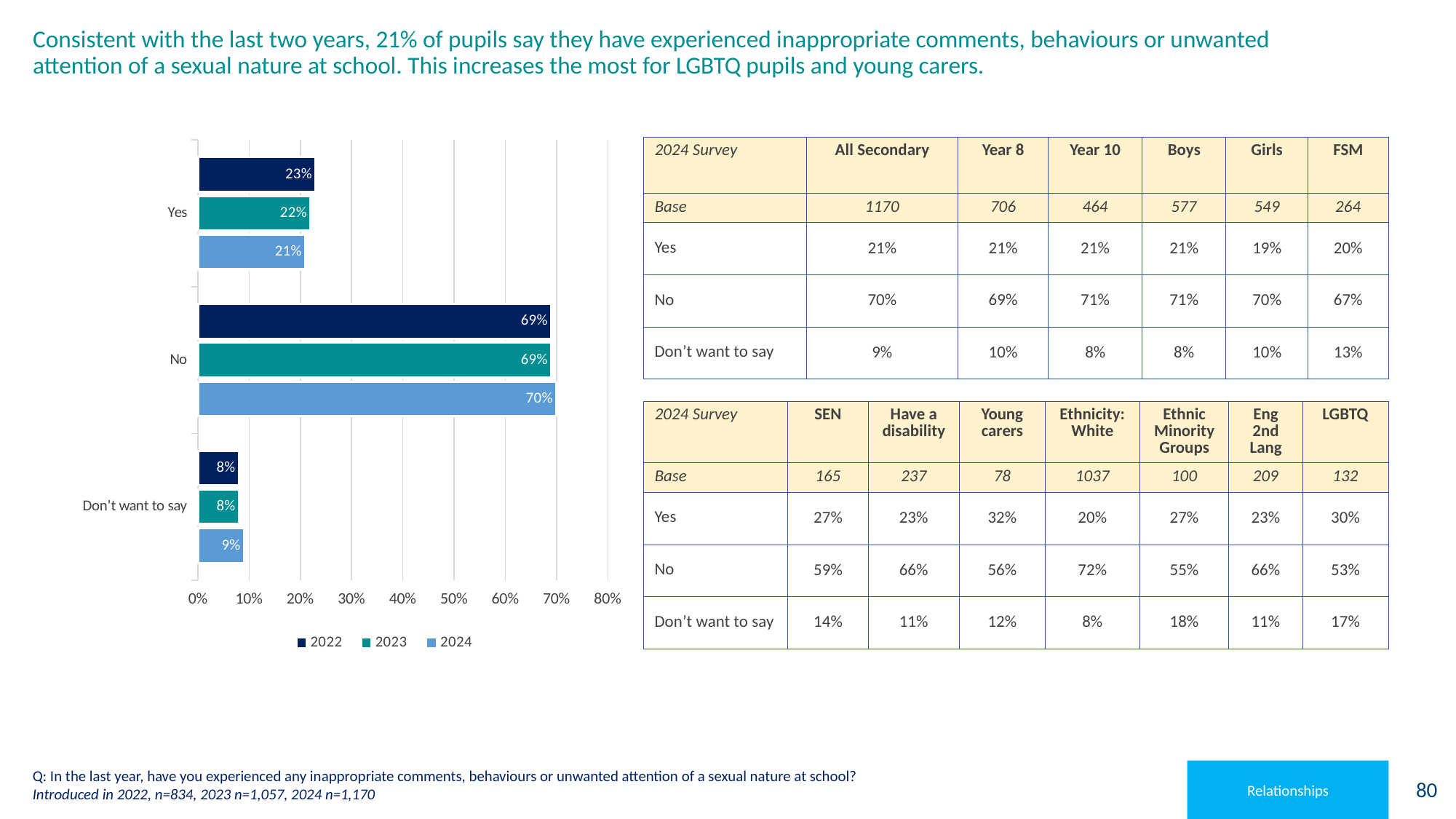
Which response category has the highest value in 2024? No Which response category has the lowest value in 2022? Don't want to say What percentage of pupils answered 'No' in 2022? 69% How many series does the legend list? 3 What type of chart is shown on the slide? Bar chart Which is larger: the 'No' value for 2024 or the 'No' value for 2023? 2024 What is the difference between the 'Yes' value in 2022 and the 'Yes' value in 2024? 2 percentage points What percentage of pupils answered 'Yes' in 2023? 22% What percentage of pupils answered 'Don't want to say' in 2024? 9% How many response categories are shown on the chart? 3 What percentage of pupils answered 'Yes' in 2024? 21% Which year is represented by the darkest bars in the chart? 2022